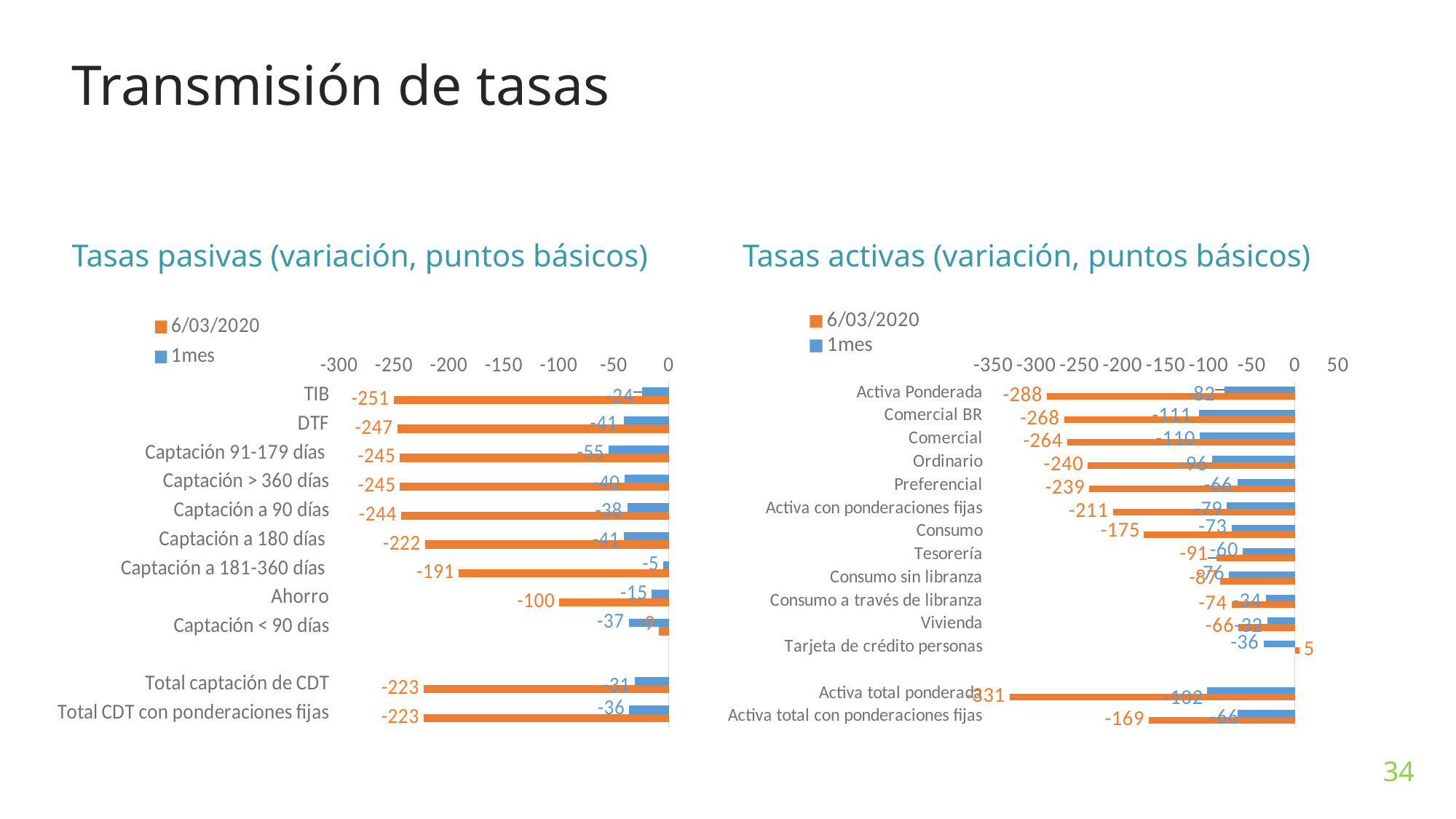
How many categories are plotted in the 'Tasas activas' chart? 14 In the 'Tasas pasivas' chart, which category has the lowest (most negative) 6/03/2020 value? TIB In the 'Tasas pasivas' chart, which is more negative for Captación < 90 días: the 6/03/2020 value or the 1mes value? 1mes In the 'Tasas pasivas' chart, what is the 6/03/2020 value for TIB? -251 In the 'Tasas pasivas' chart, what is the 6/03/2020 value for Ahorro? -100 In the 'Tasas pasivas' chart, what is the 1mes value for Captación 91-179 días? -55 In the 'Tasas activas' chart, which category has the only positive 6/03/2020 value? Tarjeta de crédito personas What type of chart is the 'Tasas activas' chart? Bar chart How many series does the legend of the 'Tasas pasivas' chart list? 2 In the 'Tasas activas' chart, what is the 6/03/2020 value for Activa total ponderada? -331 In the 'Tasas activas' chart, what is the 1mes value for Comercial BR? -111 In the 'Tasas activas' chart, what is the difference between the 6/03/2020 value and the 1mes value for Consumo? 102